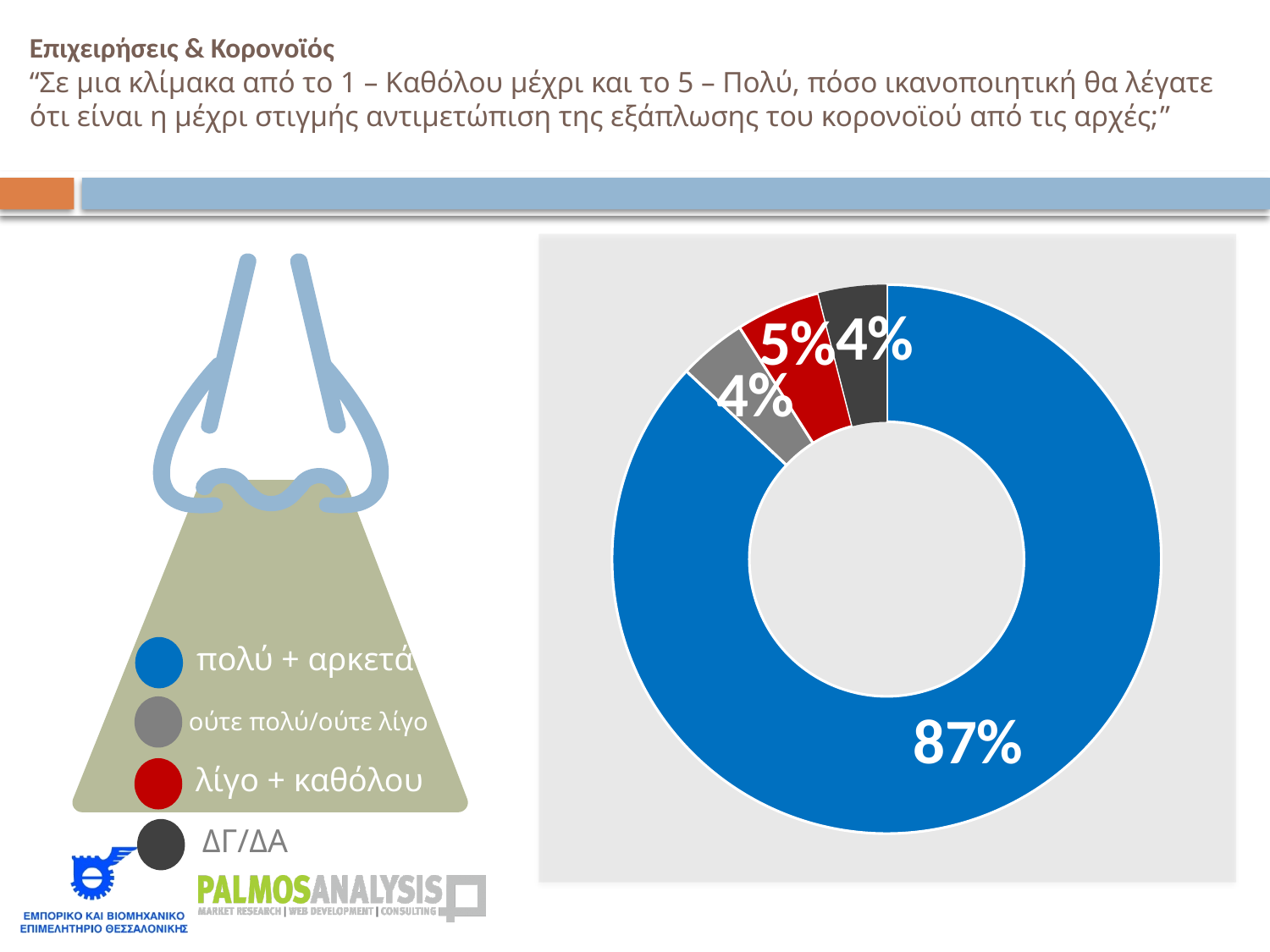
What percentage of respondents answered "πολύ + αρκετά"? 87% How many categories are shown in the chart? 4 What is the combined share of "λίγο + καθόλου" and "ΔΓ/ΔΑ"? 9% What colour represents "λίγο + καθόλου" in the chart? Red What colour represents "πολύ + αρκετά" in the chart? Blue What is the difference in percentage points between "πολύ + αρκετά" and "λίγο + καθόλου"? 82 What percentage of respondents answered "ΔΓ/ΔΑ"? 4% What percentage of respondents answered "λίγο + καθόλου"? 5% Which is larger, the share for "λίγο + καθόλου" or the share for "ούτε πολύ/ούτε λίγο"? λίγο + καθόλου What kind of chart is shown on the slide? Doughnut chart Which category has the largest share of the chart? πολύ + αρκετά What percentage of respondents answered "ούτε πολύ/ούτε λίγο"? 4%